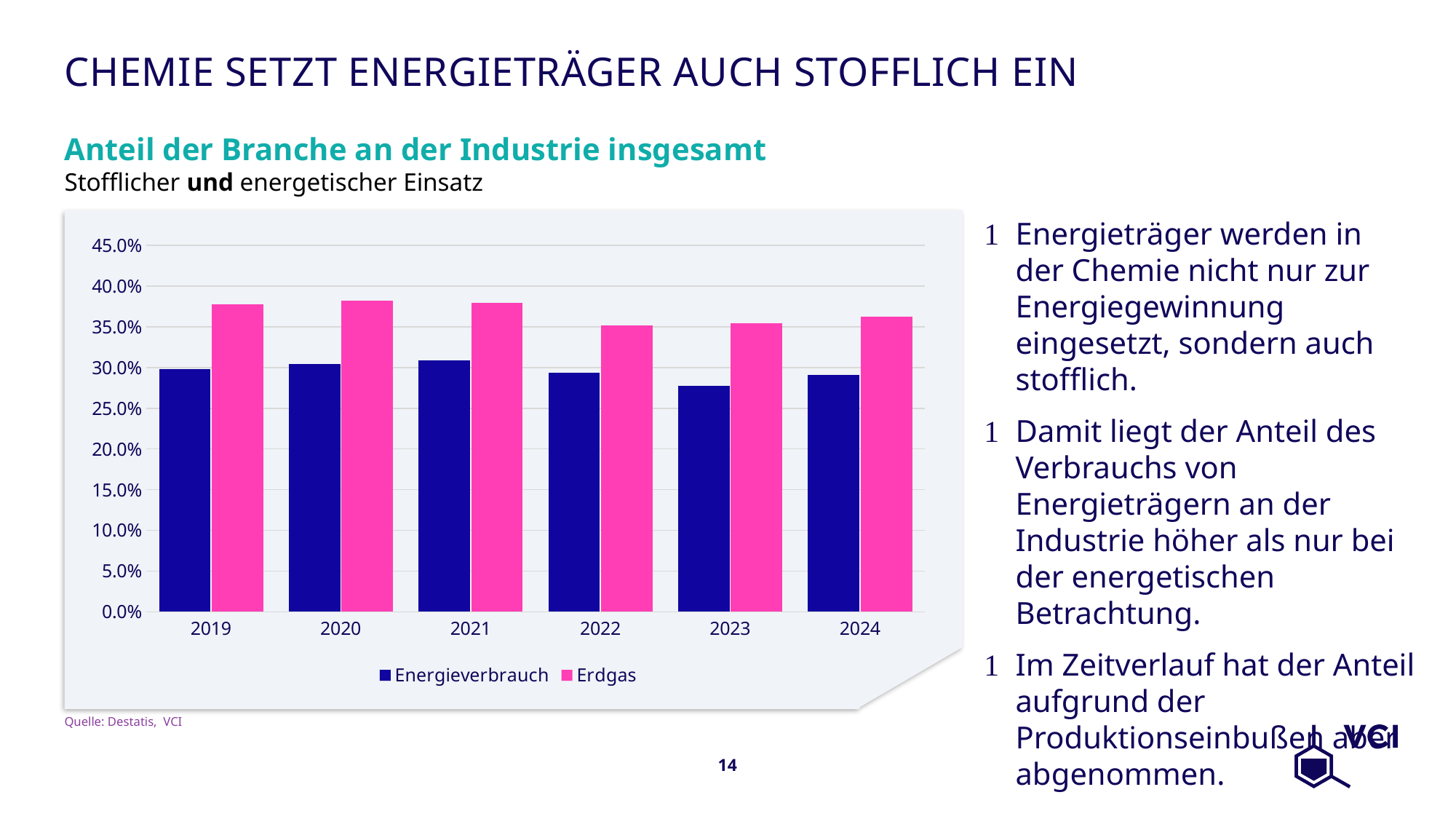
What kind of chart is shown on the slide? bar chart Does the Erdgas value rise or fall from 2021 to 2022? fall Which series is shown in pink? Erdgas Which is larger in 2022, Energieverbrauch or Erdgas? Erdgas Is the Erdgas value for 2019 greater or less than 35.0%? greater Is the Erdgas value for 2024 greater or less than 40.0%? less How many series does the legend list? 2 Which year has the larger Energieverbrauch value, 2021 or 2023? 2021 In which year is the Energieverbrauch value lowest? 2023 What is the title of the chart? Anteil der Branche an der Industrie insgesamt Is the Energieverbrauch value for 2023 greater or less than 30.0%? less How many years are shown on the x axis? 6